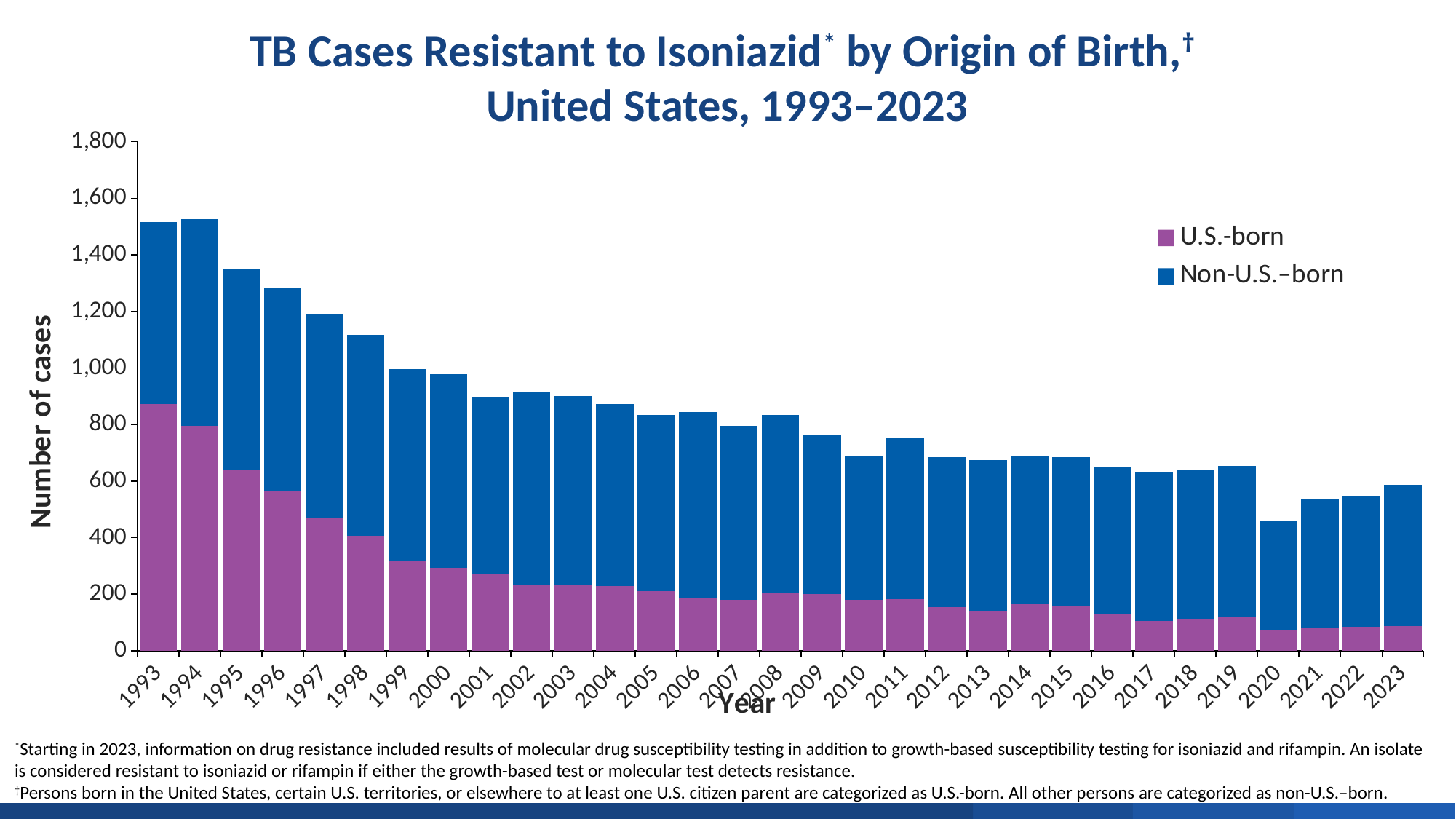
Which year has the larger total number of cases, 1993 or 2023? 1993 How many series does the legend list? 2 Is the total number of cases in 2020 greater or less than 500? less Which year has the lowest total number of isoniazid-resistant TB cases? 2020 What kind of chart is shown on the slide? Stacked bar chart Is the number of U.S.-born cases in 2020 greater or less than 100? less Is the total number of cases in 2010 greater or less than 800? less Overall, do the total number of cases rise or fall from 1993 to 2023? fall How many years are shown along the x axis? 31 Which year has more U.S.-born cases, 1995 or 1996? 1995